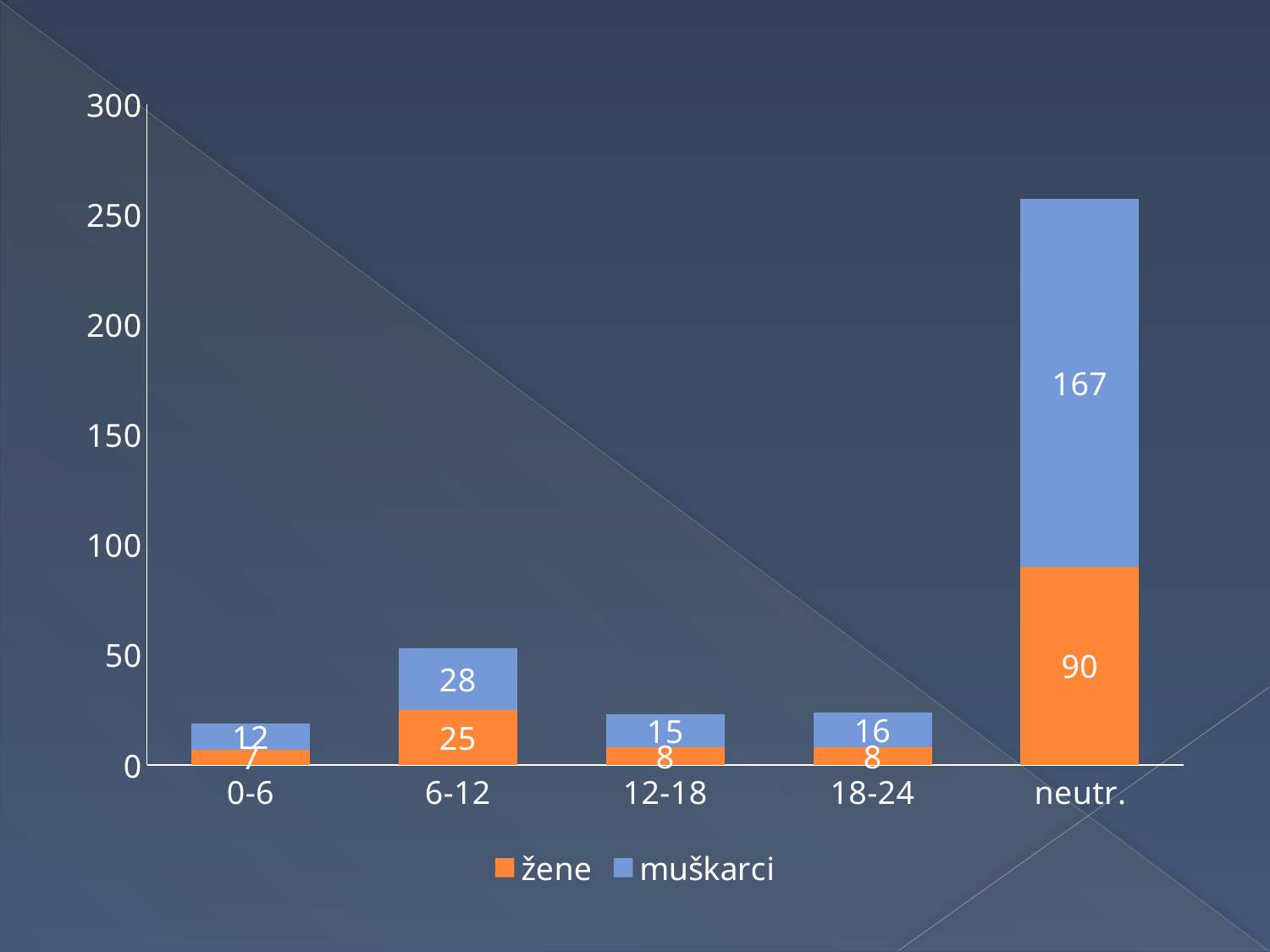
Is the value for muškarci in 18-24 larger or smaller than the value for muškarci in 12-18? larger What is the value for žene in the 12-18 category? 8 Which category has the lowest stacked bar? 0-6 Is the total stacked bar for neutr. greater or less than 250? greater What is the value for muškarci in the 6-12 category? 28 What is the difference between muškarci and žene in the neutr. category? 77 What is the total of the stacked bar for 6-12? 53 What is the total of the stacked bar for neutr.? 257 What is the value for žene in the neutr. category? 90 Which category has the highest stacked bar? neutr. How many series does the legend list? 2 What is the value for muškarci in the neutr. category? 167